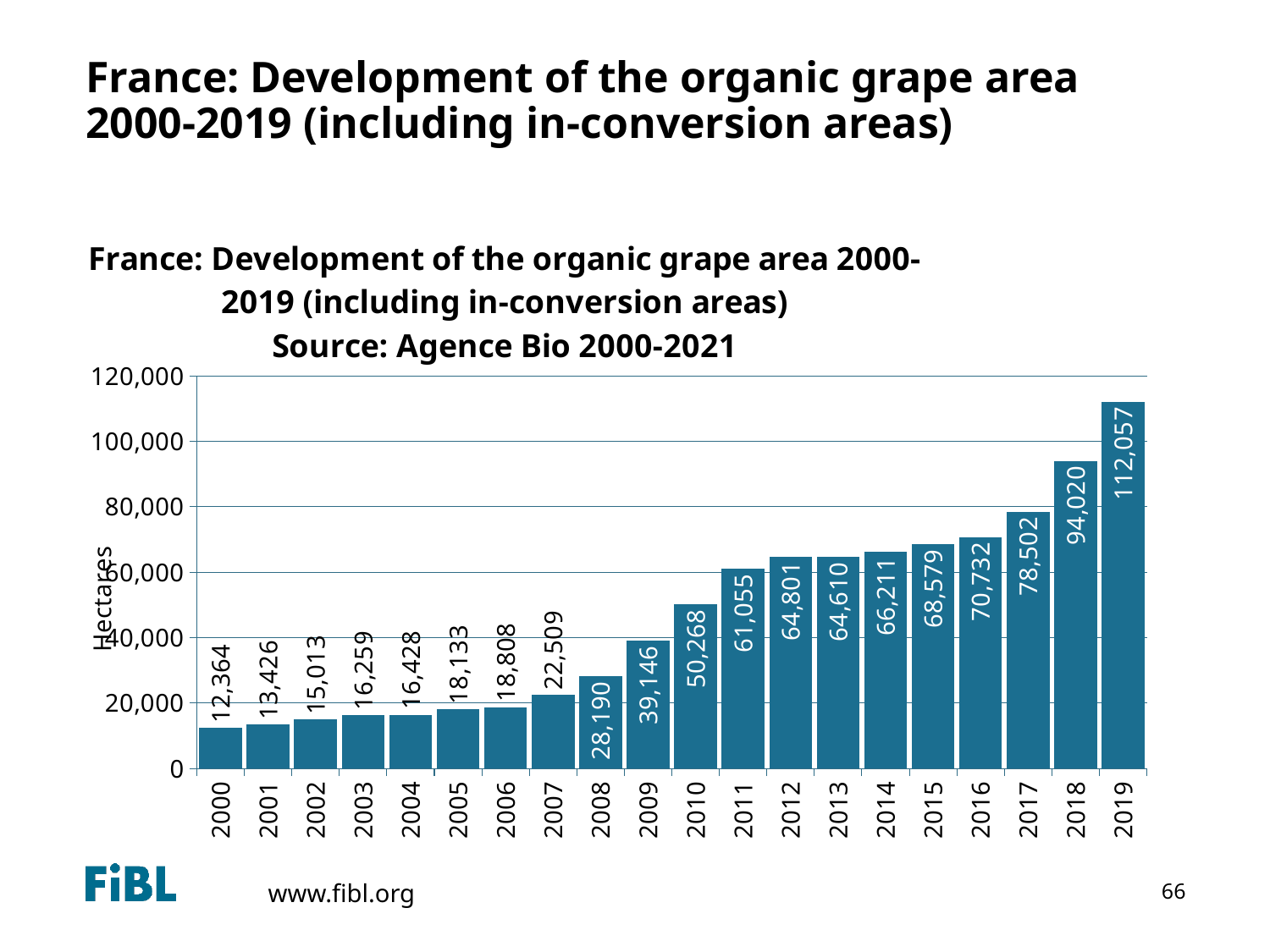
Do the values rise or fall from 2000 to 2019? rise What unit is shown on the y axis label? Hectares What was the organic grape area in France in 2019? 112,057 Which year has the lowest organic grape area? 2000 Which year has the highest organic grape area? 2019 Is the value for 2017 greater or less than 80,000? less What kind of chart is shown on the slide? bar chart Which year had a larger organic grape area, 2012 or 2013? 2012 What was the organic grape area in France in 2010? 50,268 What is the difference in organic grape area between 2019 and 2018? 18,037 What was the organic grape area in France in 2000? 12,364 How many years are shown on the x axis? 20